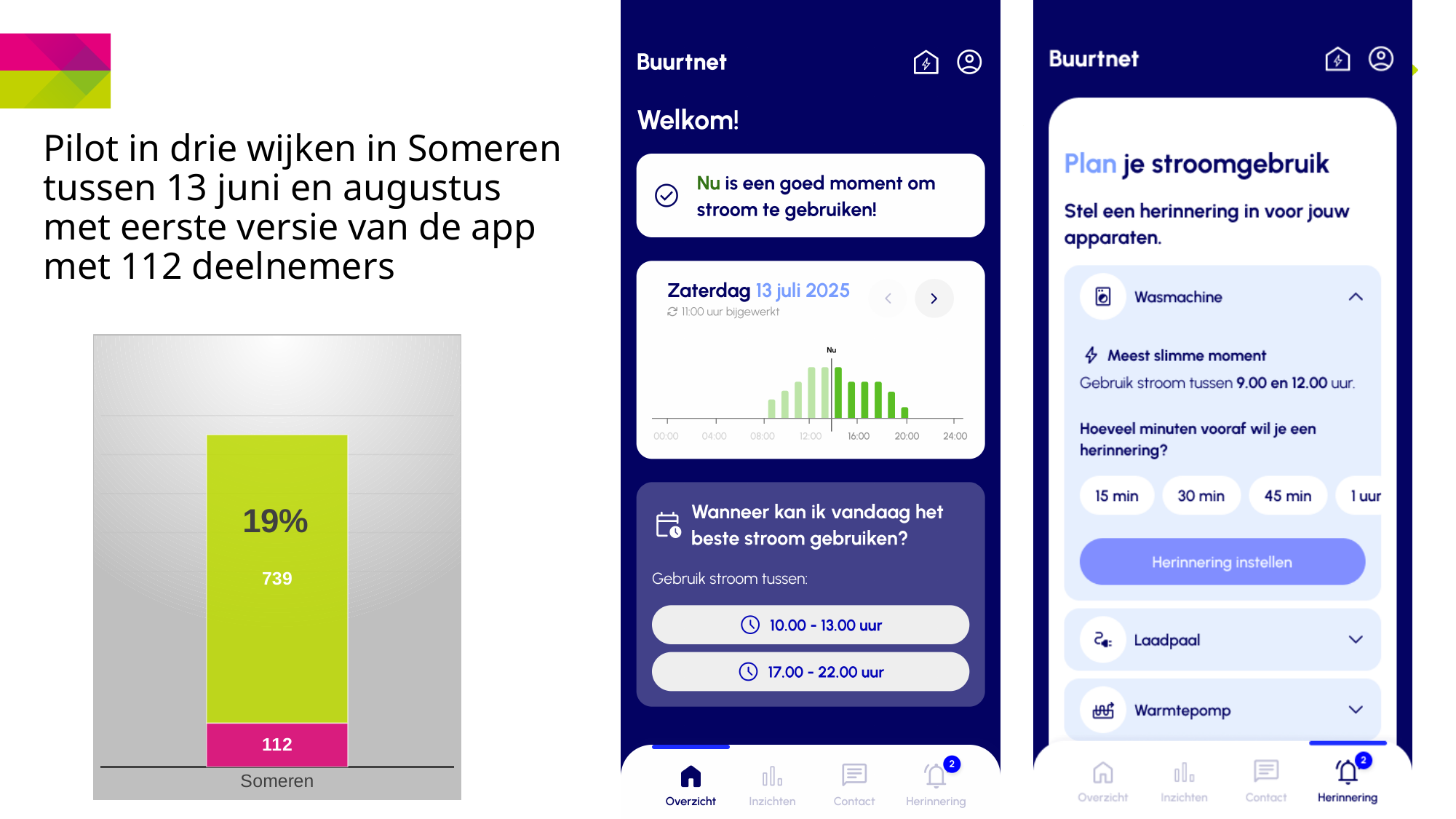
How many categories are shown on the x axis of the bar chart on the left? 1 In the bar chart on the left, which segment of the Someren bar is larger, the green one or the pink one? The green one (739) In the bar chart on the left, what value is printed on the green (top) segment of the Someren bar? 739 What is the category label on the x axis of the bar chart on the left? Someren What percentage label is printed inside the green segment of the bar chart on the left? 19% In the bar chart on the left, what is the total of the two segments of the Someren bar? 851 In the bar chart on the left, what is the difference between the green segment (739) and the pink segment (112)? 627 In the bar chart on the left, which segment has the smallest value? The pink segment (112) In the bar chart on the left, what value is printed on the pink (bottom) segment of the Someren bar? 112 What kind of chart is shown on the left of the slide? Stacked bar chart